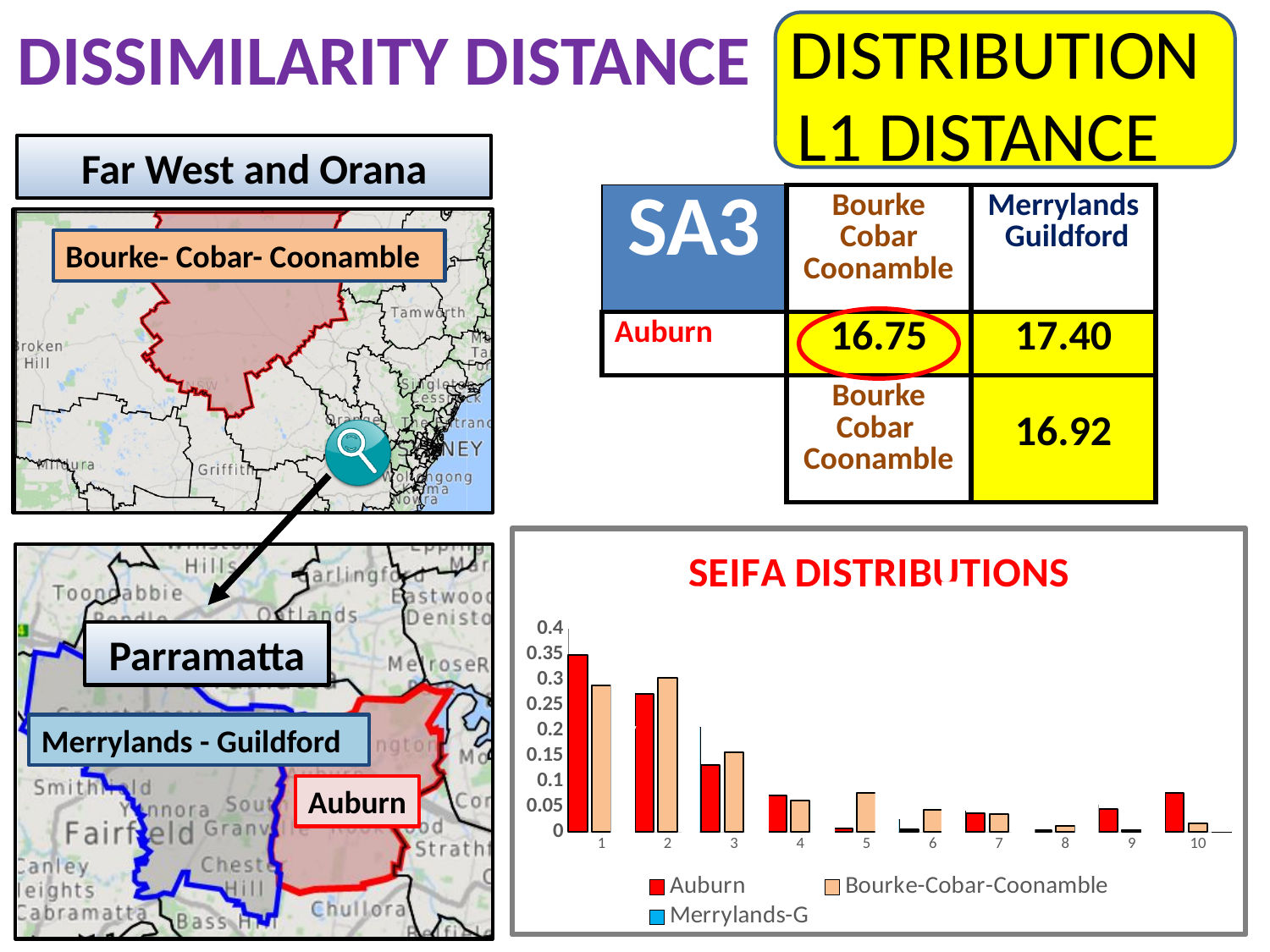
What is the title of the bar chart on the slide? SEIFA DISTRIBUTIONS How many categories are shown on the x axis of the SEIFA DISTRIBUTIONS chart? 10 In the SEIFA DISTRIBUTIONS chart, do the Auburn values generally rise or fall from category 1 to category 5? fall What kind of chart is the SEIFA DISTRIBUTIONS chart? bar chart How many series does the legend of the SEIFA DISTRIBUTIONS chart list? 3 In the SEIFA DISTRIBUTIONS chart, which series has the larger value at category 10, Auburn or Bourke-Cobar-Coonamble? Auburn In the SEIFA DISTRIBUTIONS chart, is the Auburn value at category 1 greater or less than 0.3? greater In the SEIFA DISTRIBUTIONS chart, is the Auburn value at category 3 greater or less than 0.1? greater In the SEIFA DISTRIBUTIONS chart, at which category is the Auburn value highest? 1 In the SEIFA DISTRIBUTIONS chart, is the Bourke-Cobar-Coonamble value at category 5 greater or less than 0.1? less In the SEIFA DISTRIBUTIONS chart, which series has the larger value at category 2, Auburn or Bourke-Cobar-Coonamble? Bourke-Cobar-Coonamble